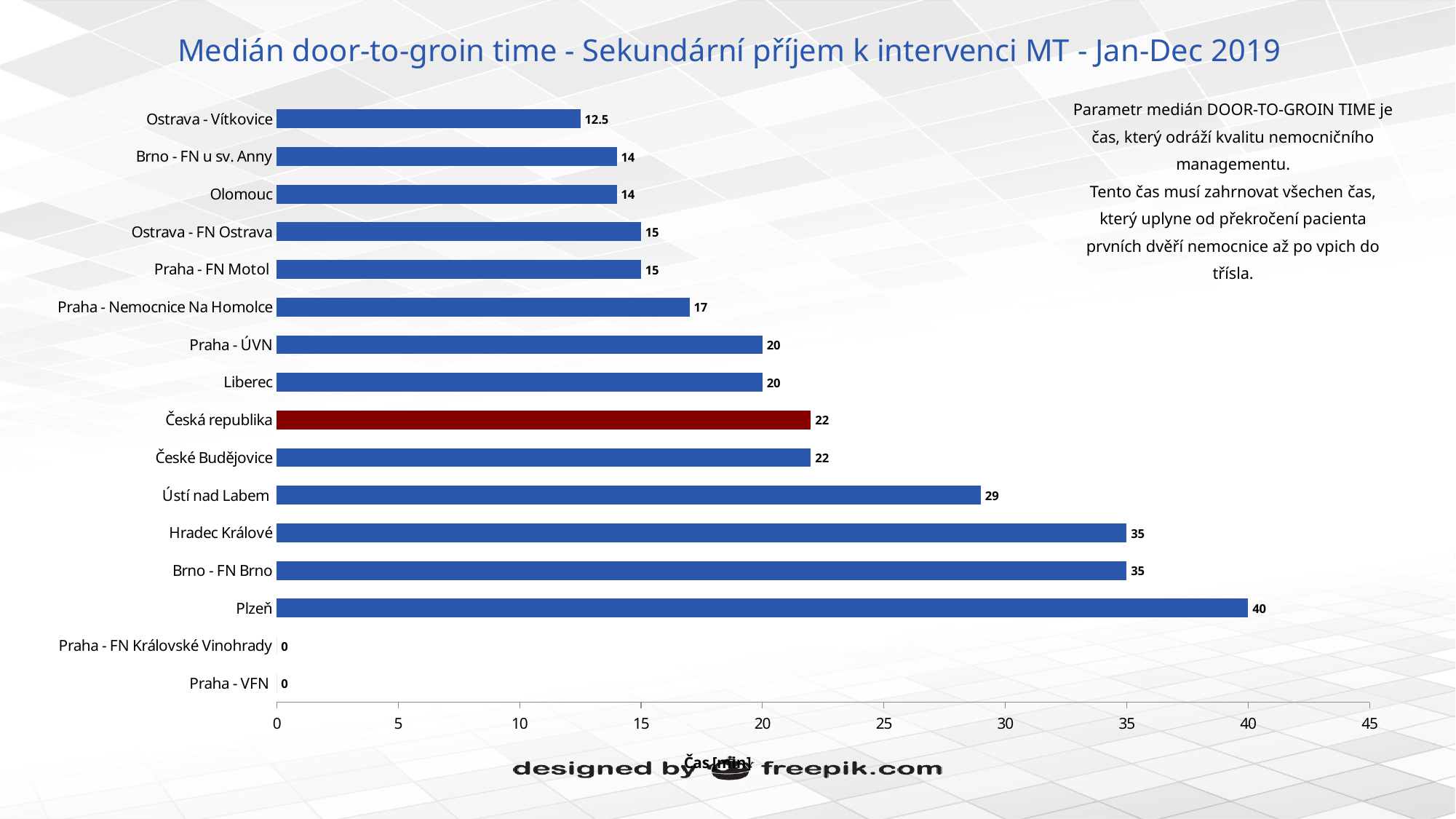
What kind of chart is shown on the slide? Bar chart Which category's bar is coloured dark red instead of blue? Česká republika What is the median door-to-groin time for Ostrava - Vítkovice? 12.5 Is the value for Brno - FN Brno greater or less than 30? greater Which is larger, the value for Praha - Nemocnice Na Homolce or the value for Liberec? Liberec Which category has the highest value among those with a non-zero bar? Plzeň What is the value shown for Ústí nad Labem? 29 What is the difference between the values for Ústí nad Labem and Praha - ÚVN? 9 How many categories are shown on the chart? 16 Which category has the lowest non-zero value? Ostrava - Vítkovice What is the difference between the values for Plzeň and Hradec Králové? 5 What is the value shown for Česká republika? 22